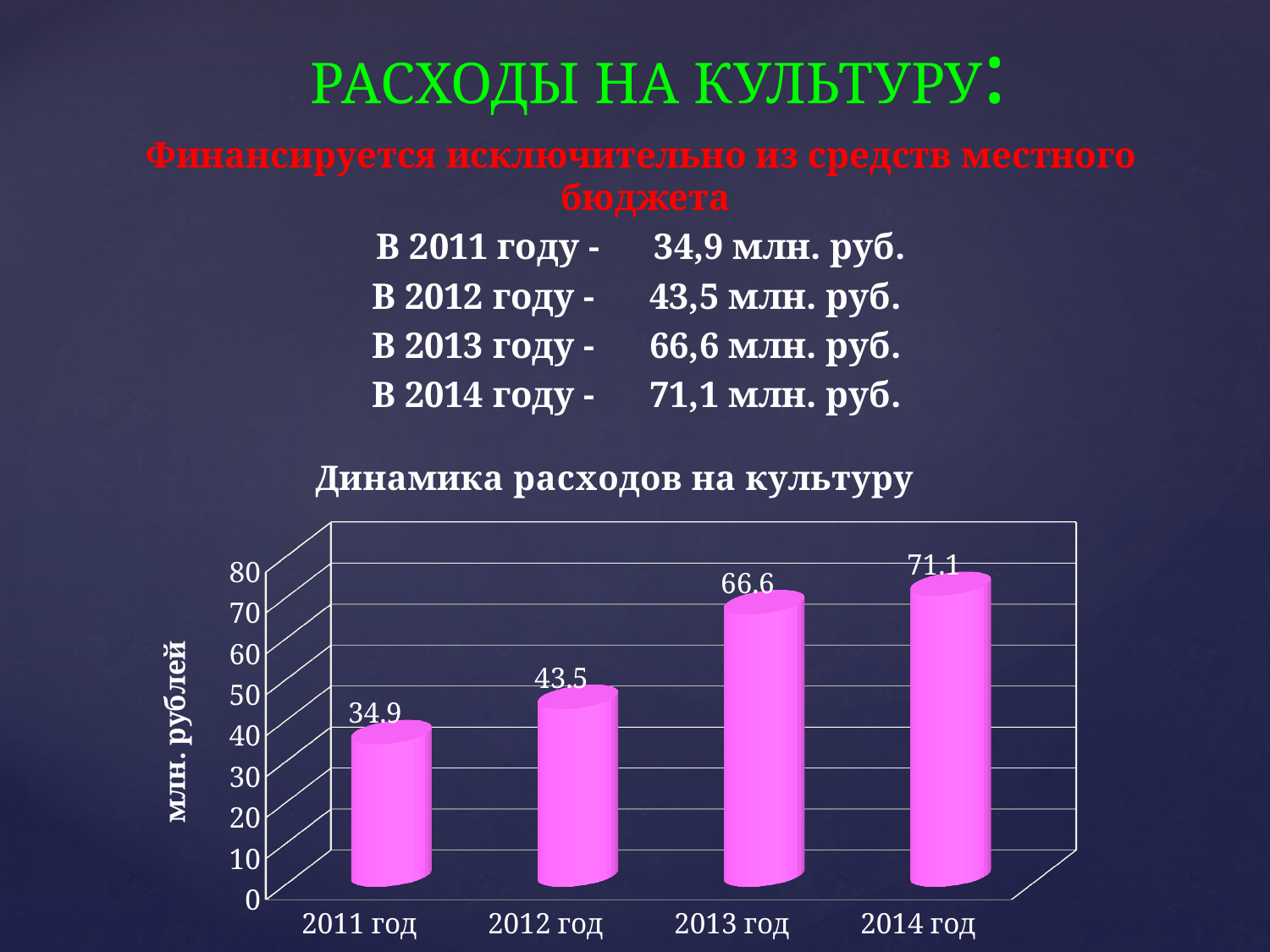
How many years are shown in the chart 'Динамика расходов на культуру'? 4 What is the value for 2014 год in the chart 'Динамика расходов на культуру'? 71.1 What is the difference between the values for 2013 год and 2012 год in the chart 'Динамика расходов на культуру'? 23.1 What is the value for 2011 год in the chart 'Динамика расходов на культуру'? 34.9 Do the values in the chart 'Динамика расходов на культуру' rise or fall from 2011 год to 2014 год? rise What is the difference between the values for 2014 год and 2011 год in the chart 'Динамика расходов на культуру'? 36.2 Which is larger in the chart 'Динамика расходов на культуру': the value for 2012 год or the value for 2013 год? 2013 год Which year has the lowest value in the chart 'Динамика расходов на культуру'? 2011 год What is the value for 2013 год in the chart 'Динамика расходов на культуру'? 66.6 Is the value for 2012 год in the chart 'Динамика расходов на культуру' greater or less than 50? less Which year has the highest value in the chart 'Динамика расходов на культуру'? 2014 год What kind of chart is 'Динамика расходов на культуру'? bar chart